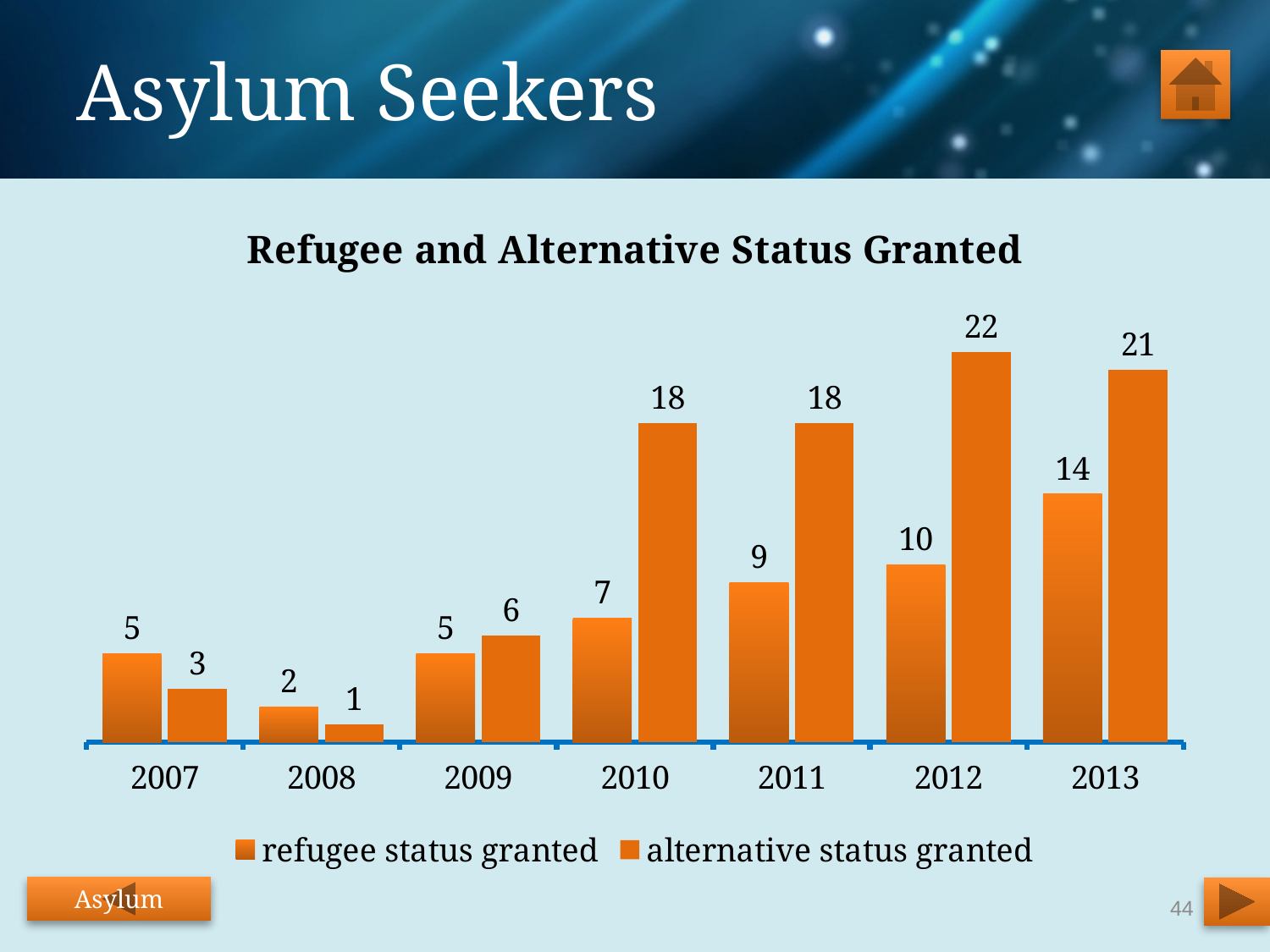
In which year is the value for refugee status granted lowest? 2008 In which year is the value for alternative status granted highest? 2012 What is the value for refugee status granted in 2013? 14 Does the value for refugee status granted generally rise or fall from 2008 to 2013? rise Which is larger in 2007, refugee status granted or alternative status granted? refugee status granted What type of chart is shown on the slide? bar chart What is the value for alternative status granted in 2012? 22 What is the value for alternative status granted in 2008? 1 What is the difference between alternative status granted and refugee status granted in 2010? 11 How many series does the legend list? 2 What is the title of the chart? Refugee and Alternative Status Granted How many years are shown on the x axis? 7